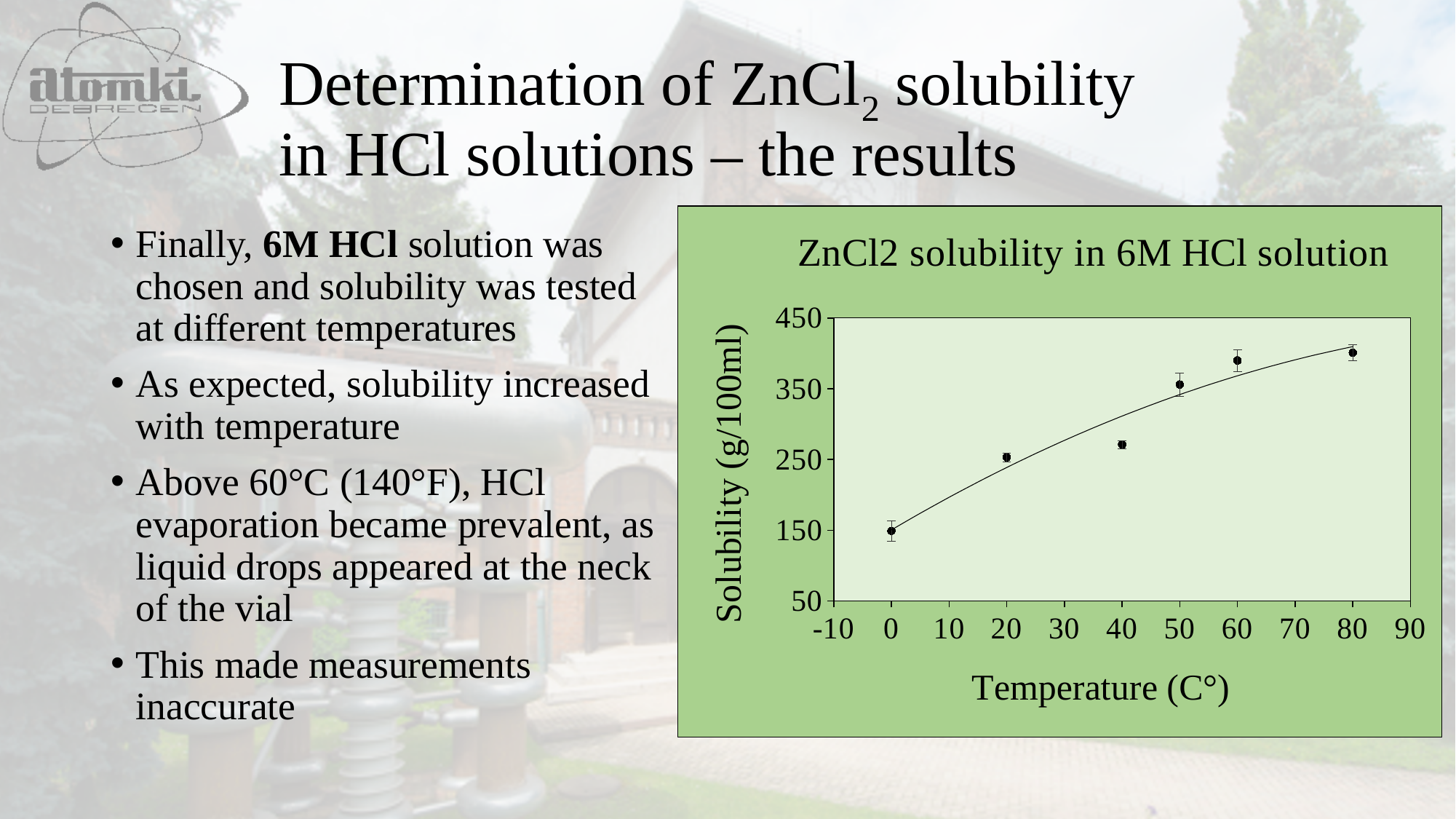
At which temperature is the plotted solubility lowest? 0 What kind of chart is shown on the slide? scatter plot How many data points are plotted in the chart? 6 Does solubility rise or fall as temperature increases along the x axis? rise Is the solubility value at 40 °C greater or less than 350? less Is the solubility value at 0 °C greater or less than 250? less Which has the higher solubility value, 20 °C or 50 °C? 50 °C Is the solubility value at 80 °C greater or less than 450? less What is the label of the y axis of the chart? Solubility (g/100ml) What is the title of the chart? ZnCl2 solubility in 6M HCl solution